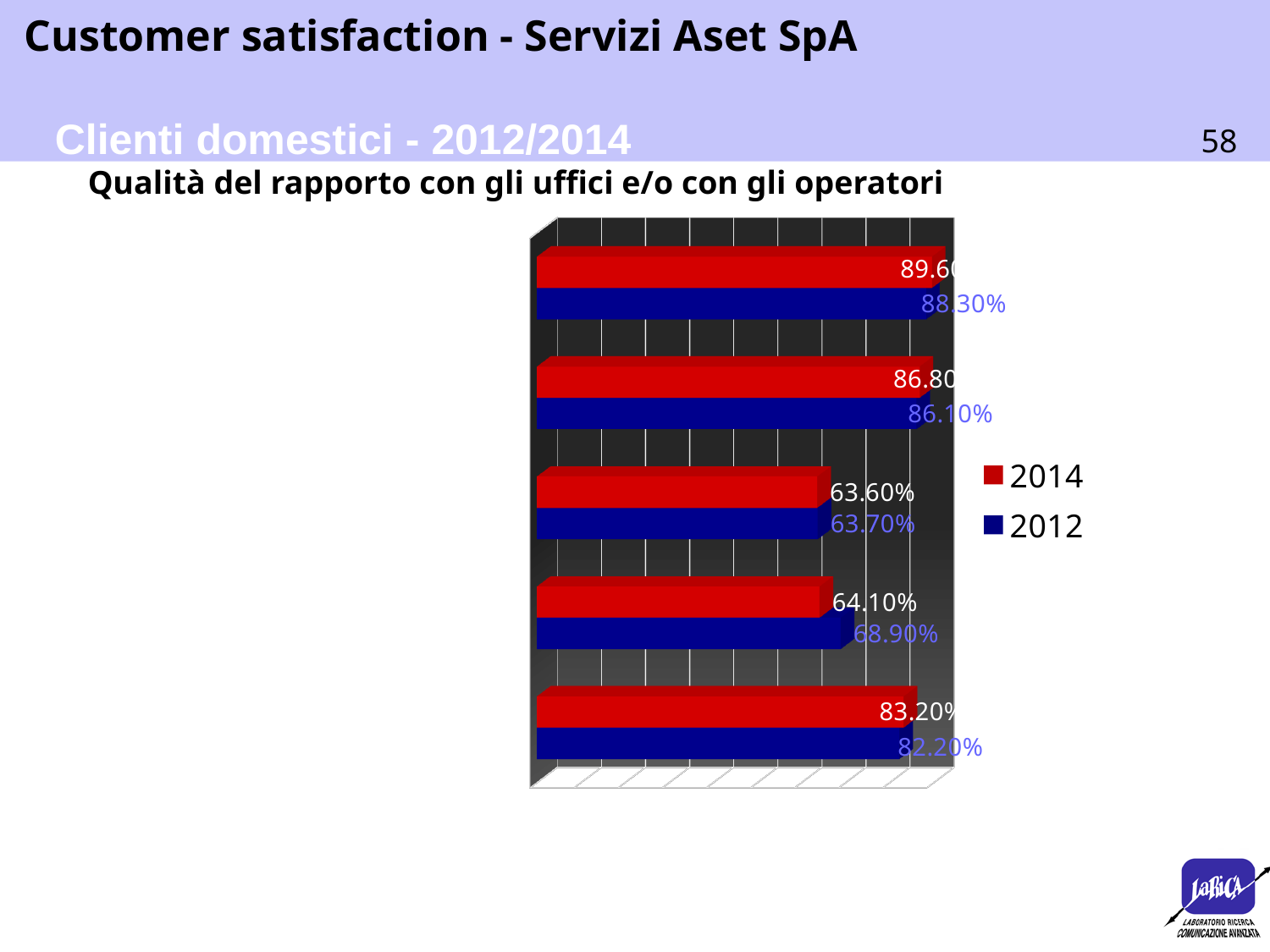
What is the 2012 value for the bottom pair of bars? 82.20% In the fourth pair of bars from the top, what is the difference between the 2012 value and the 2014 value? 4.80 percentage points What is the 2012 value for the fourth pair of bars from the top? 68.90% Which is the lowest 2014 value shown in the chart? 63.60% What is the 2012 value for the topmost pair of bars? 88.30% What is the 2014 value for the bottom pair of bars? 83.20% Which colour represents the 2014 series in the legend? red What is the 2014 value for the third pair of bars from the top? 63.60% How many pairs of bars (categories) are plotted in the chart? 5 In the bottom pair of bars, which year has the larger value, 2014 or 2012? 2014 What kind of chart is shown on the slide? bar chart How many series does the legend list? 2